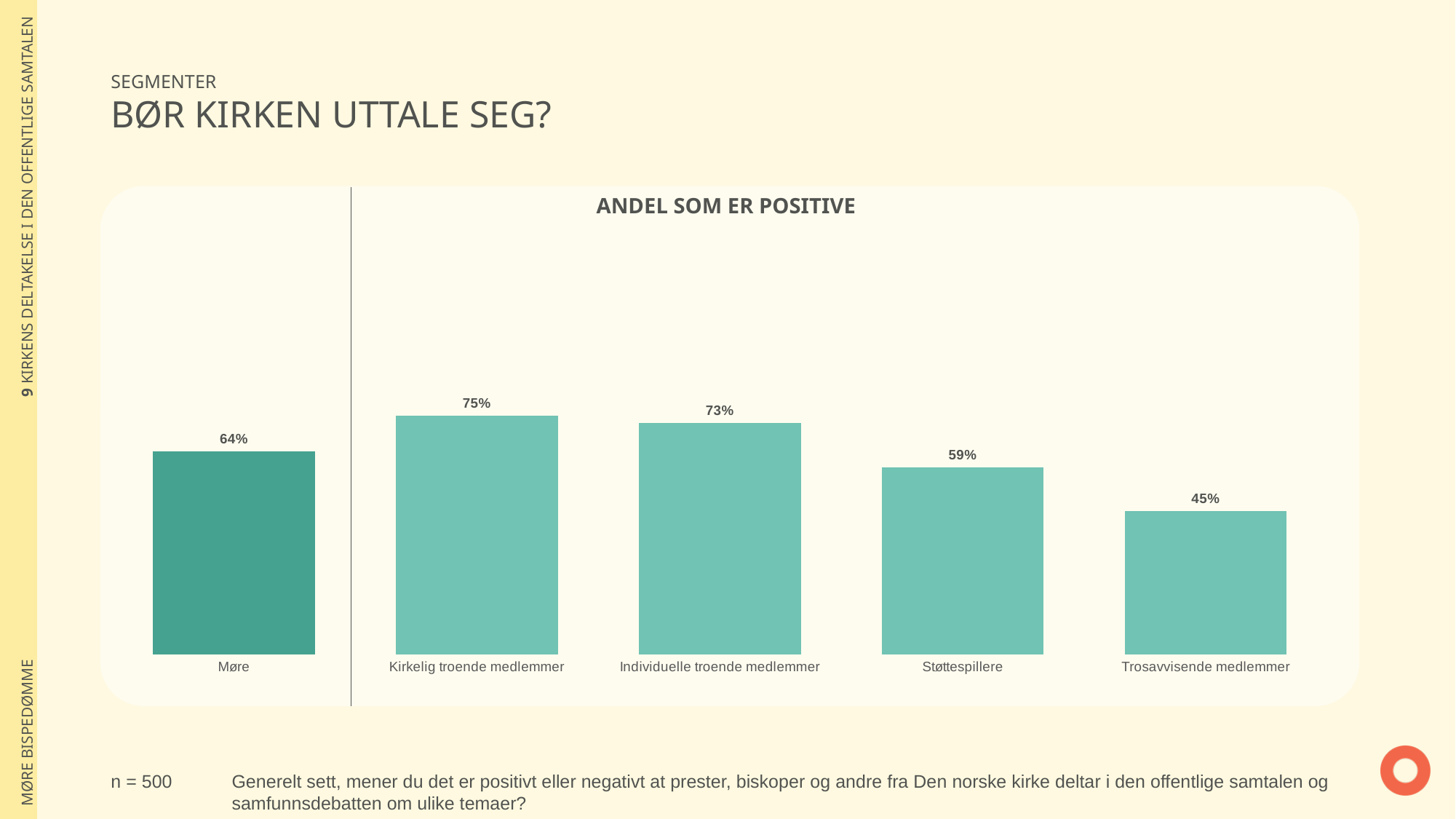
What kind of chart is shown on the slide? Bar chart What is the value for Trosavvisende medlemmer? 45% What is the difference between the values for Kirkelig troende medlemmer and Trosavvisende medlemmer? 30% How many categories are shown in the chart? 5 Which category has the lowest value? Trosavvisende medlemmer Which is larger, the value for Støttespillere or the value for Møre? Møre What is the value for Kirkelig troende medlemmer? 75% What is the difference between the values for Individuelle troende medlemmer and Møre? 9% What is the value for Støttespillere? 59% Which category has the highest value? Kirkelig troende medlemmer What is the title of the chart? ANDEL SOM ER POSITIVE What is the value for Møre? 64%